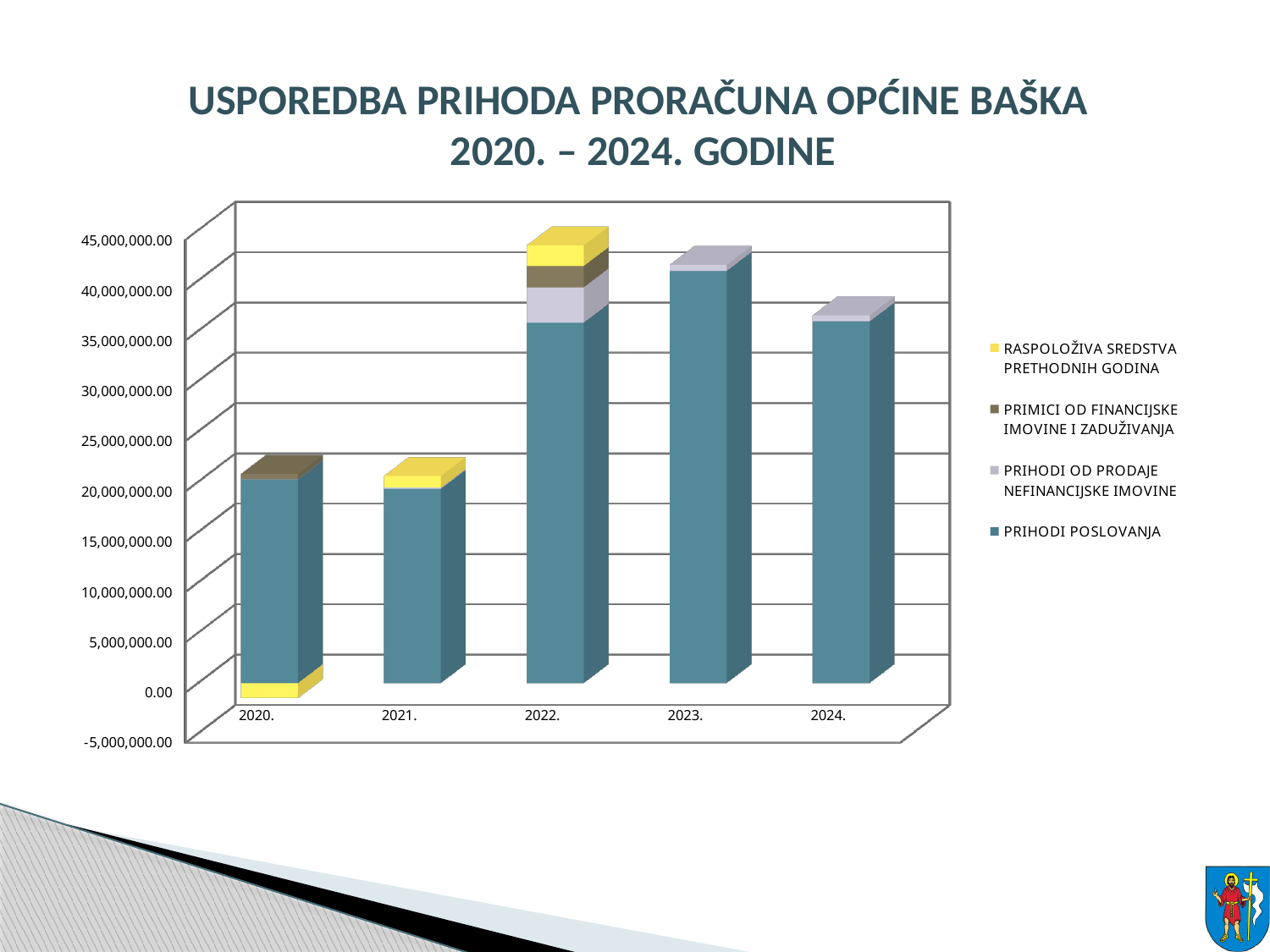
Which year has the larger total stacked bar, 2023. or 2024.? 2023. How many years (categories) are shown on the x axis of the chart? 5 How many series does the chart legend list? 4 Which series is shown in yellow in the chart legend? RASPOLOŽIVA SREDSTVA PRETHODNIH GODINA Is the total stacked bar for 2024. greater or less than 30,000,000.00? greater What is the title of the chart on the slide? USPOREDBA PRIHODA PRORAČUNA OPĆINE BAŠKA 2020. – 2024. GODINE Is the total stacked bar for 2023. greater or less than 40,000,000.00? greater What kind of chart is shown on the slide? Stacked bar chart Which year has the larger total stacked bar, 2021. or 2022.? 2022. Is the total stacked bar for 2020. greater or less than 25,000,000.00? less Which year has the tallest stacked bar in the chart? 2022. Do the total stacked bars rise or fall from 2022. to 2024.? fall